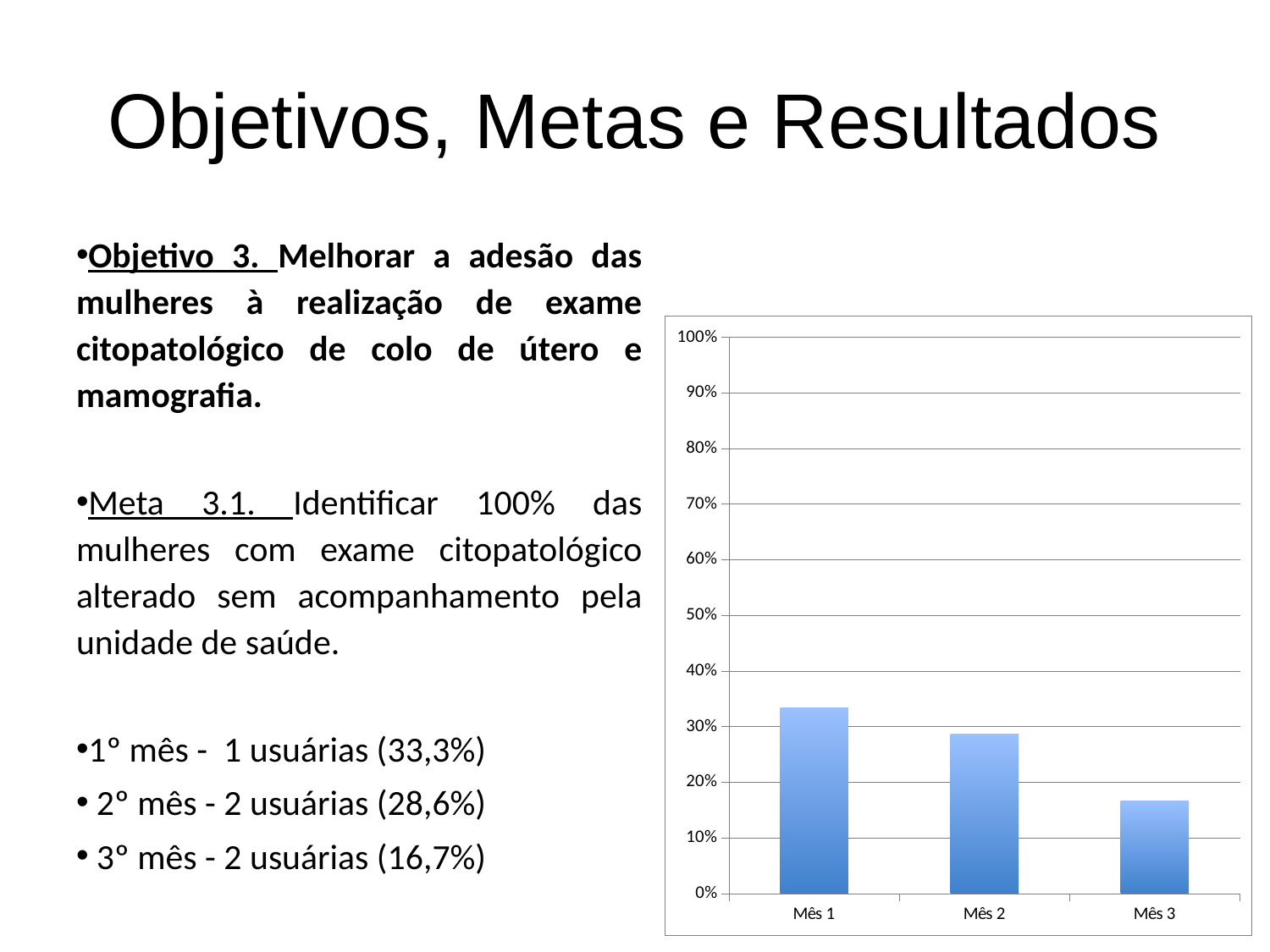
What is the highest value shown on the chart's vertical axis? 100% Do the values rise or fall from Mês 1 to Mês 3? fall How many categories are plotted on the x axis of the chart? 3 What kind of chart is shown on the slide? bar chart Is the value for Mês 3 greater or less than 10%? greater Is the value for Mês 1 greater or less than 40%? less Which month has the lowest bar in the chart? Mês 3 Is the value for Mês 3 greater or less than 20%? less Which month has the highest bar in the chart? Mês 1 Which is larger, the bar for Mês 2 or the bar for Mês 3? Mês 2